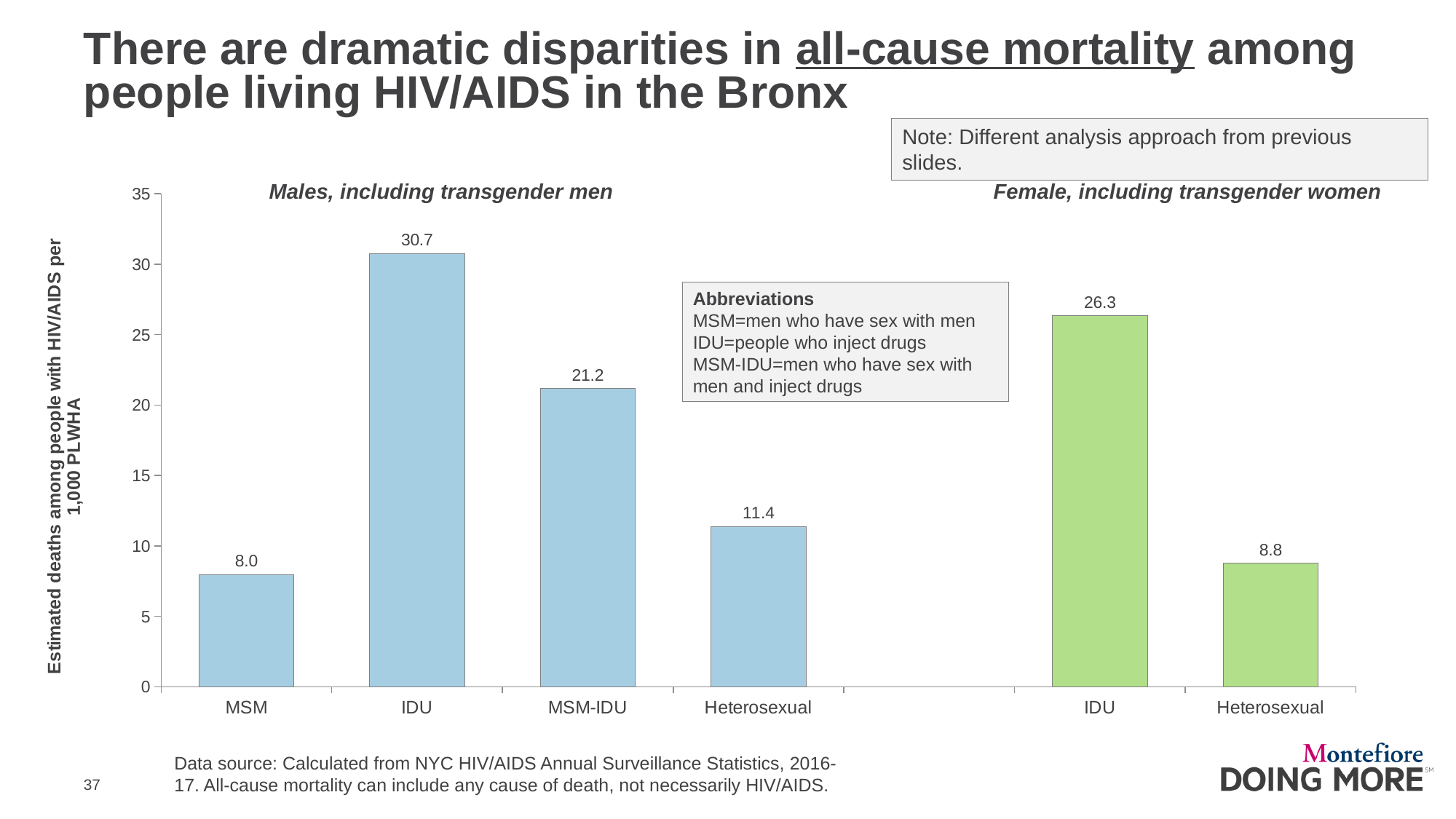
What is the value shown for the MSM bar? 8.0 Which is larger: the male Heterosexual value or the female Heterosexual value? Male Heterosexual What is the value for the MSM-IDU bar? 21.2 How many bars are plotted on the chart? 6 What is the difference between the male Heterosexual value and the female Heterosexual value? 2.6 What is the estimated all-cause mortality rate for males in the IDU group? 30.7 What is the difference between the male IDU value and the female IDU value? 4.4 Which bar has the highest value on the chart? IDU (males) What colour are the bars for the female group? Green What is the value for females in the Heterosexual group? 8.8 Which bar has the lowest value on the chart? MSM What kind of chart is shown on the slide? Bar chart